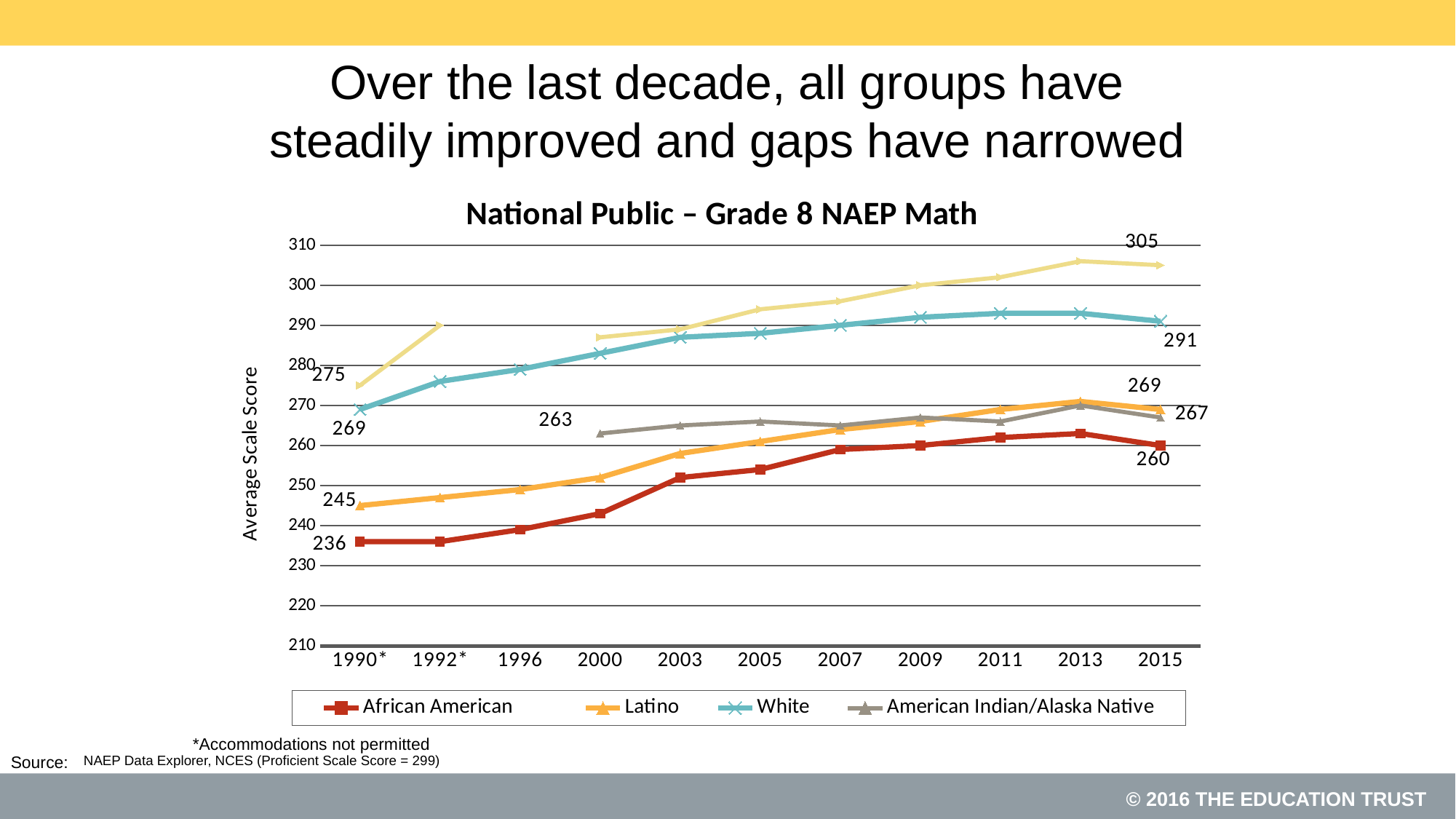
In 2015, which group had the higher score: Latino or American Indian/Alaska Native? Latino What was the average scale score for African American students in 2015? 260 What is the difference between the 2015 scores of White students and African American students? 31 What was the average scale score for Latino students in 1990*? 245 What was the average scale score for American Indian/Alaska Native students in 2000? 263 How many years are shown on the x axis? 11 What was the average scale score for White students in 1990*? 269 What was the average scale score for White students in 2015? 291 By how many points did the African American average scale score increase from 1990* to 2015? 24 Is the value for African American students in 2000 greater or less than 250? less What kind of chart is shown on the slide? line chart How many series does the legend list? 4